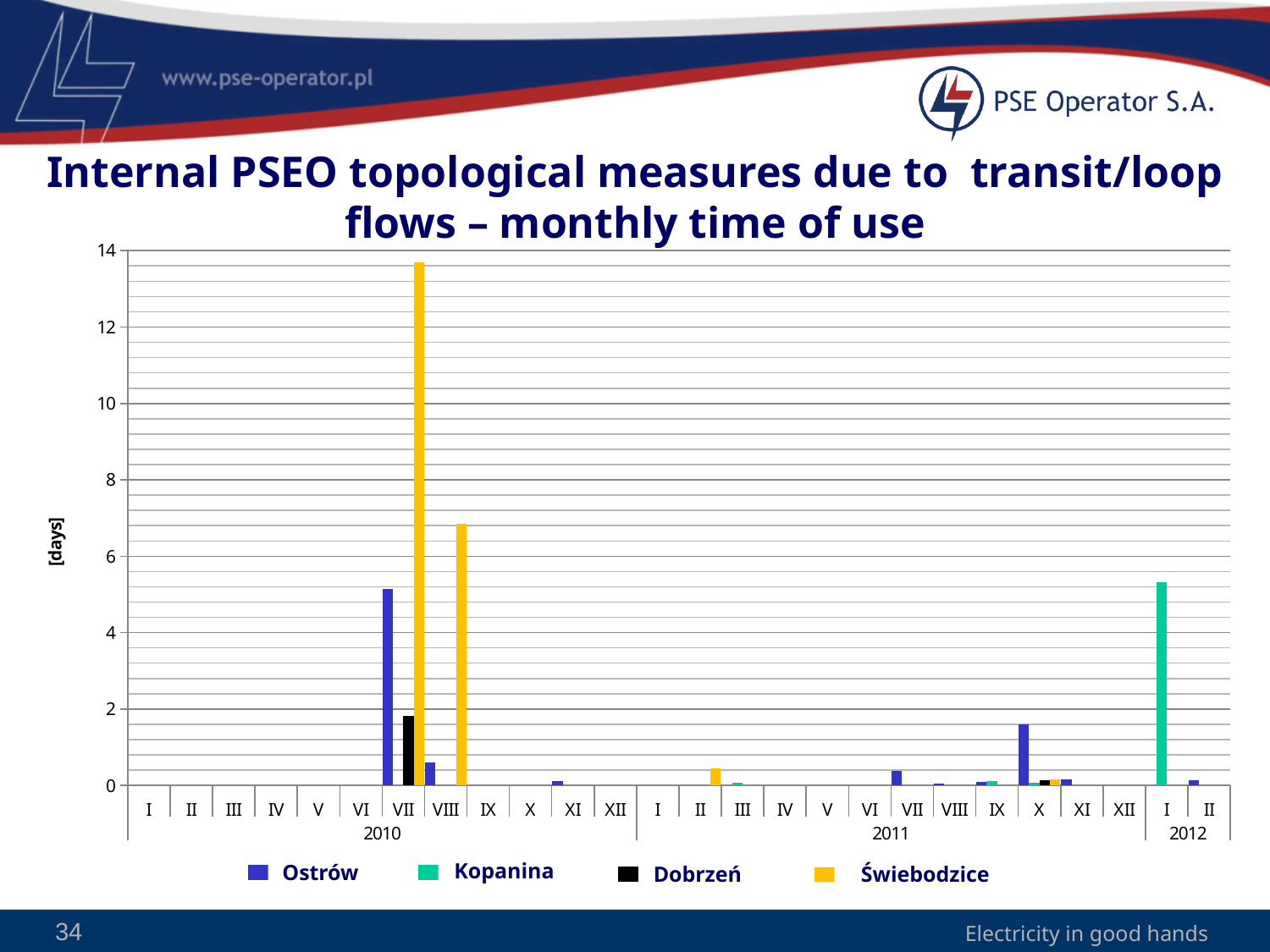
Is the value for Kopanina in month I of 2012 greater or less than 4? greater How many series does the legend list? 4 Is the value for Ostrów in month VII of 2010 greater or less than 4? greater Which series has the tallest bar in month I of 2012? Kopanina What kind of chart is shown on the slide? bar chart Is the value for Świebodzice in month VII of 2010 greater or less than 12? greater What unit is shown on the vertical axis label? [days] Which is larger: the Świebodzice value in month VII of 2010 or in month VIII of 2010? month VII of 2010 Which series has the tallest bar in month VII of 2010? Świebodzice